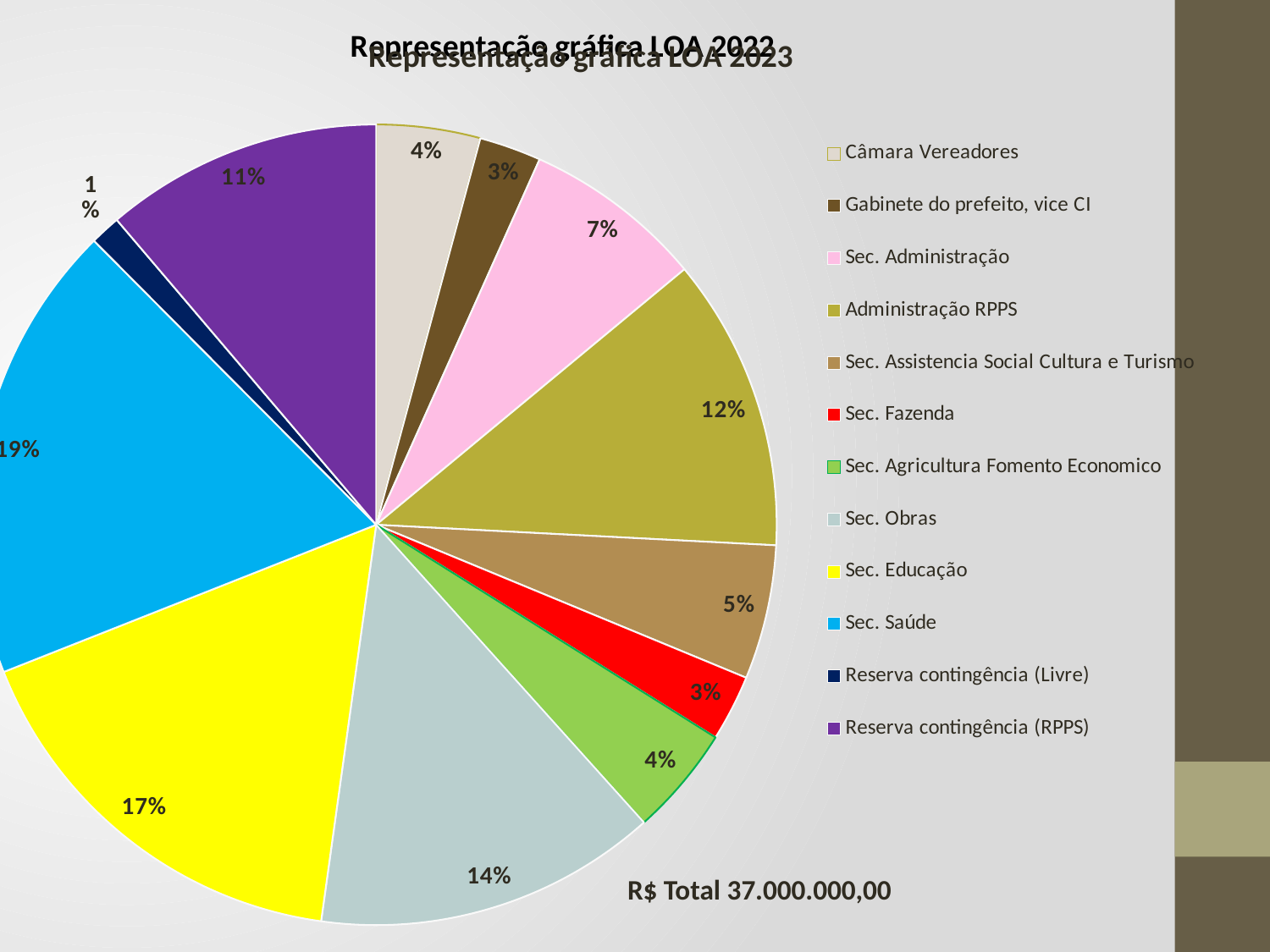
What is the difference in percentage points between Sec. Saúde and Sec. Educação? 2 What share of the pie does Sec. Saúde represent? 19% What kind of chart is shown on the slide? pie chart Which category has the largest slice of the pie? Sec. Saúde What share of the pie does Administração RPPS represent? 12% What total amount is printed below the pie chart? R$ Total 37.000.000,00 What share of the pie does Sec. Educação represent? 17% How many categories does the legend list? 12 What share of the pie does Reserva contingência (RPPS) represent? 11% What share of the pie does Sec. Obras represent? 14% Which is larger, the slice for Sec. Administração or the slice for Sec. Assistencia Social Cultura e Turismo? Sec. Administração Which category has the smallest slice of the pie? Reserva contingência (Livre)